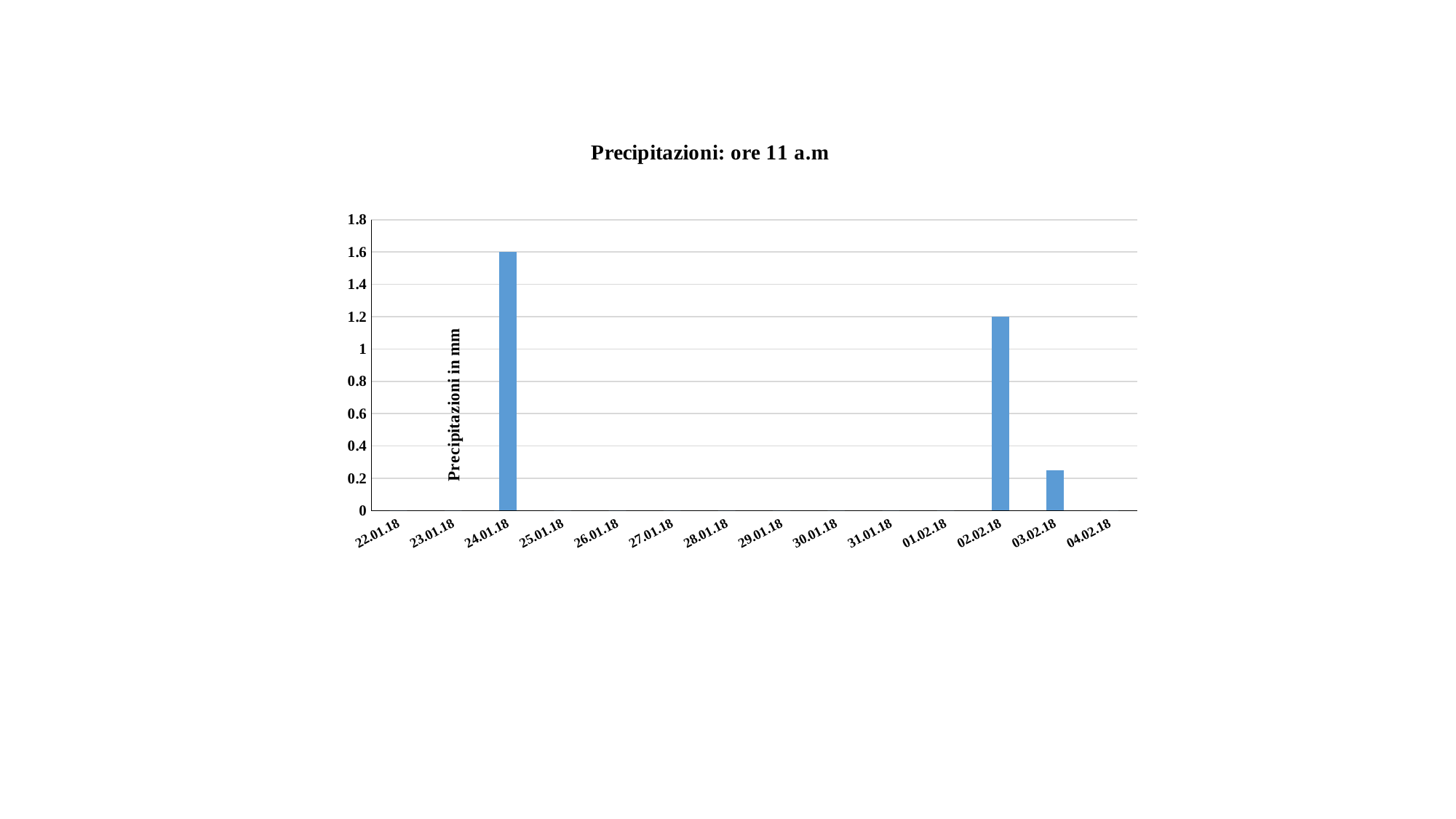
What is the precipitation value for 24.01.18? 1.6 What is the title of the chart? Precipitazioni: ore 11 a.m How many dates are shown along the x axis of the chart? 14 On how many dates does the chart show a non-zero precipitation bar? 3 Which has the larger precipitation value, 24.01.18 or 02.02.18? 24.01.18 What is the precipitation value for 02.02.18? 1.2 What is the difference between the precipitation values for 24.01.18 and 02.02.18? 0.4 What kind of chart is shown on the slide? bar chart Which date has the highest precipitation value in the chart? 24.01.18 What is the label on the vertical axis of the chart? Precipitazioni in mm Is the precipitation value for 03.02.18 greater or less than 0.4? less Among the dates with a non-zero bar, which date has the lowest precipitation value? 03.02.18